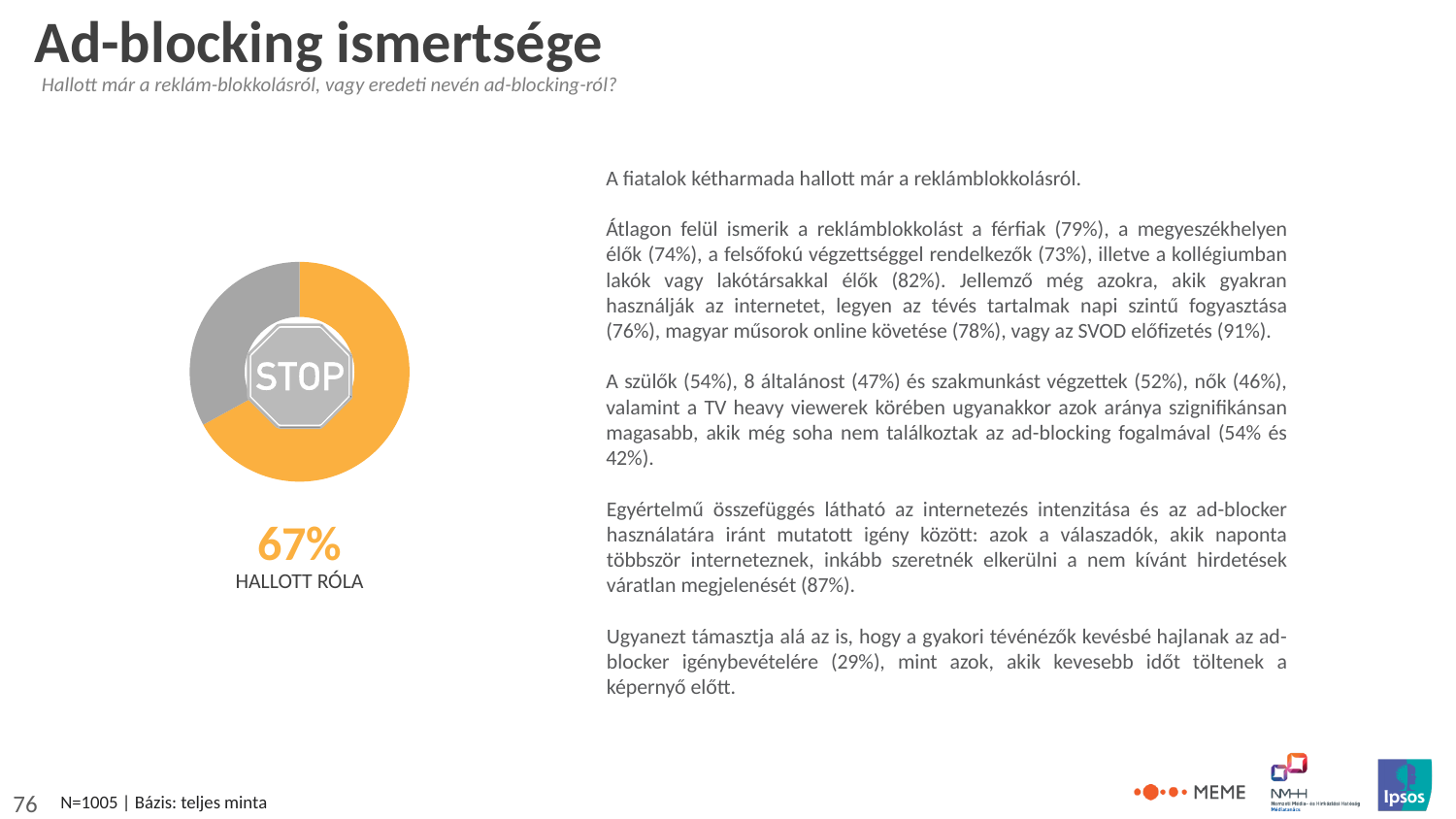
Is the share of respondents who have heard about ad-blocking greater or less than 50%? greater What is the title of the slide containing the chart? Ad-blocking ismertsége What is the sample size (N) stated at the bottom of the slide? N=1005 What kind of chart is shown on the left of the slide? Donut (pie) chart How many slices does the donut chart have? 2 What colour is the slice representing those who have heard about ad-blocking? Orange Which slice of the donut chart is larger, the orange one or the grey one? The orange one Is the grey slice of the donut chart greater or less than 50%? less What label is printed under the 67% value below the chart? HALLOTT RÓLA What percentage of respondents have heard about ad-blocking, according to the donut chart? 67%